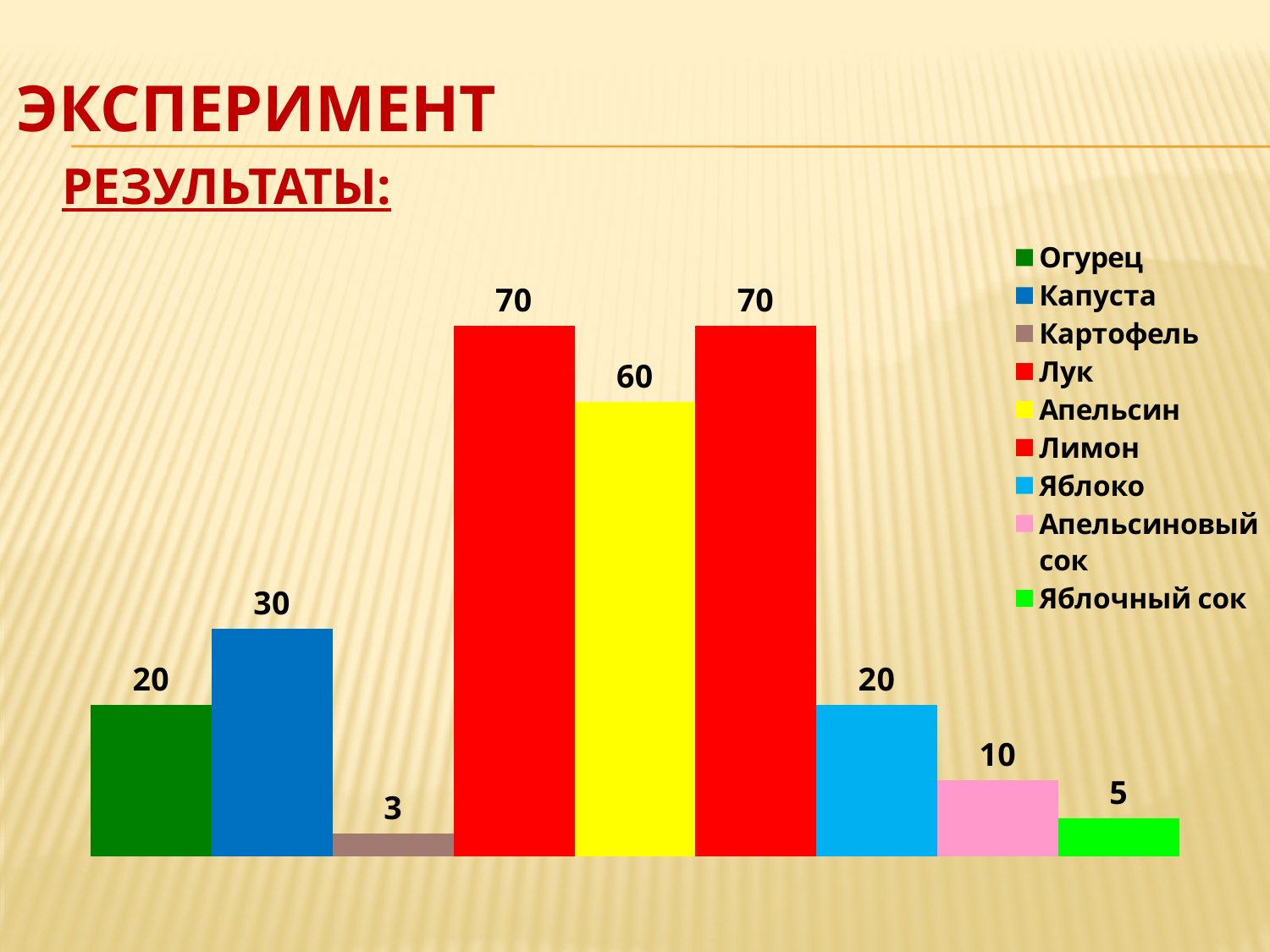
Which category has the lowest value? Картофель What is the value for Картофель? 3 Which is larger, the value for Яблоко or the value for Апельсиновый сок? Яблоко What is the difference between the values for Капуста and Огурец? 10 What is the value for Капуста? 30 How many bars are plotted in the chart? 9 What is the difference between the values for Лук and Апельсин? 10 What is the value for Яблочный сок? 5 What kind of chart is shown on the slide? Bar chart What is the value for Апельсин? 60 How many entries does the legend list? 9 What colour is the bar for Апельсин? Yellow